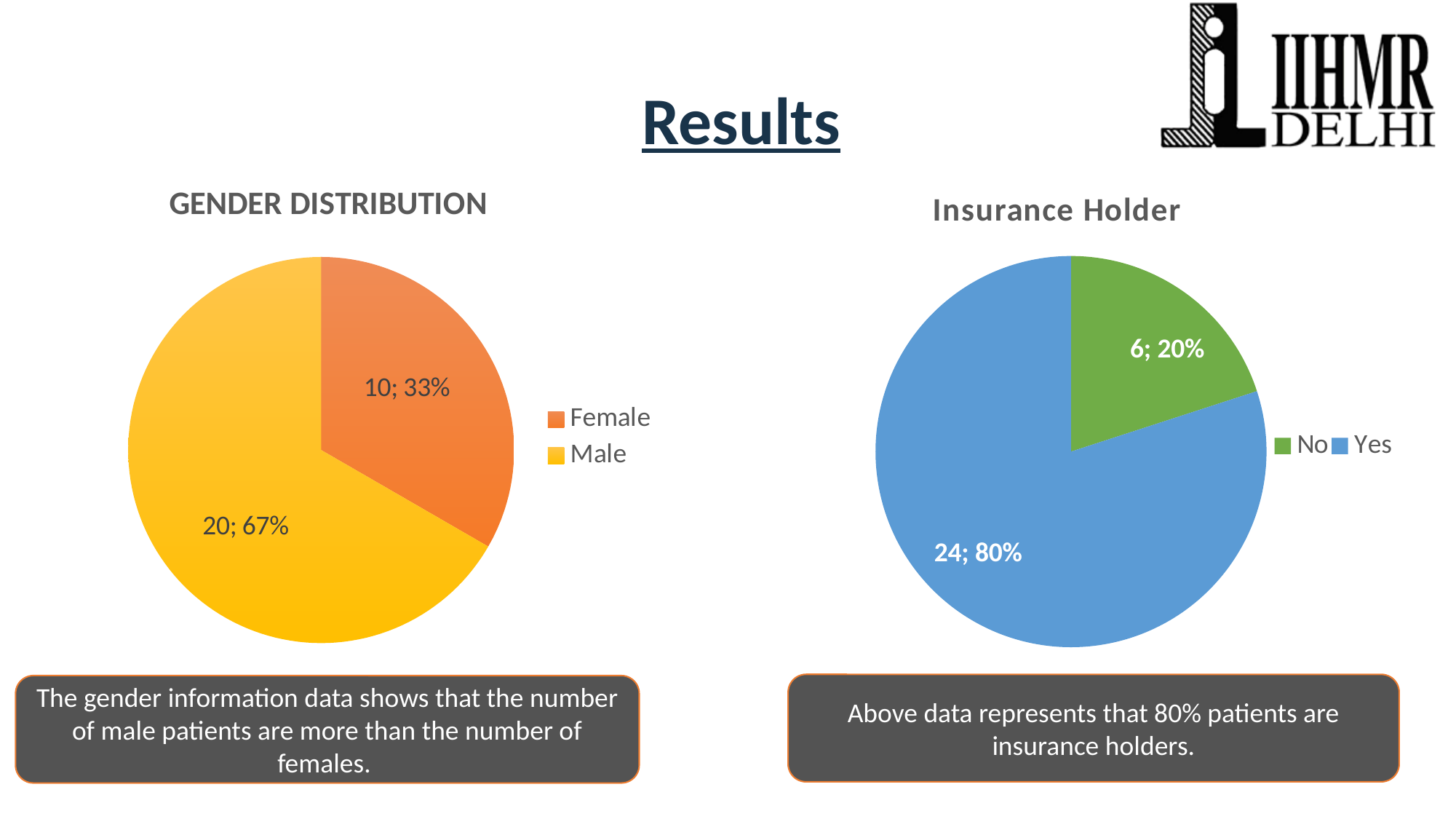
In the GENDER DISTRIBUTION chart, what is the difference between the Male and Female counts? 10 In the Insurance Holder chart, what is the difference between the Yes and No counts? 18 In the Insurance Holder chart, what colour is the Yes slice? Blue In the Insurance Holder chart, which category has the smallest slice? No In the Insurance Holder chart, how many patients answered Yes? 24 In the GENDER DISTRIBUTION chart, which is larger, the Female count or the Male count? Male In the Insurance Holder chart, what percentage share does the No slice have? 20% In the GENDER DISTRIBUTION chart, which category has the largest slice? Male In the GENDER DISTRIBUTION chart, what percentage share does the Female slice have? 33% What type of chart is the GENDER DISTRIBUTION chart? Pie chart In the GENDER DISTRIBUTION chart, how many categories are shown? 2 In the GENDER DISTRIBUTION chart, how many patients are Male? 20